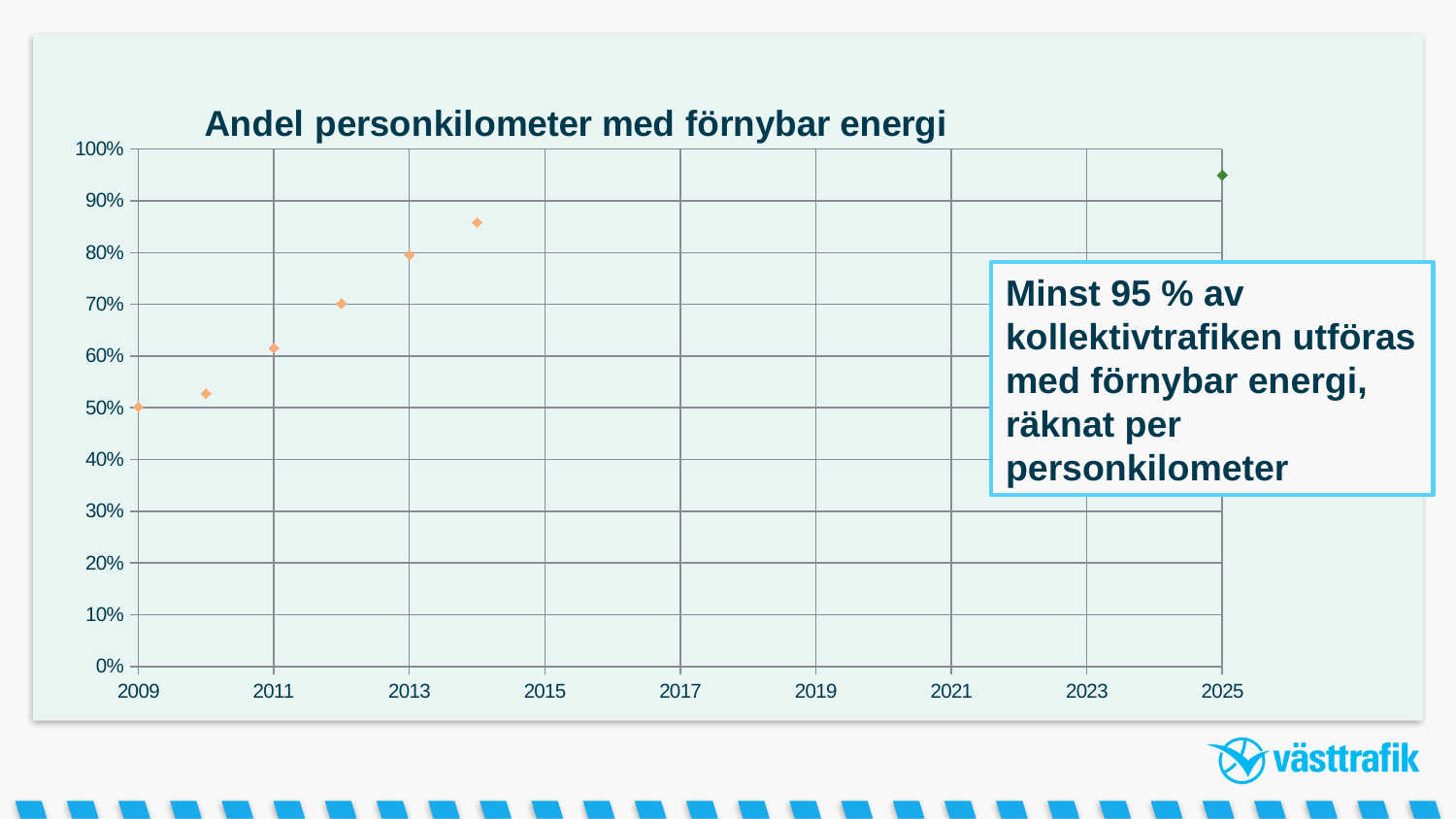
What colour is the data point for 2025? green What is the title of the chart? Andel personkilometer med förnybar energi Do the plotted values rise or fall from 2009 to 2025? rise How many data points are plotted on the chart? 7 Which has the larger value, 2010 or 2014? 2014 Is the value for 2014 greater or less than 80%? greater What is the value plotted for 2009? 50% Which year has the highest plotted value? 2025 Which year has the lowest plotted value? 2009 Is the value for 2025 greater or less than 90%? greater Is the value for 2011 greater or less than 70%? less What kind of chart is shown on the slide? scatter chart